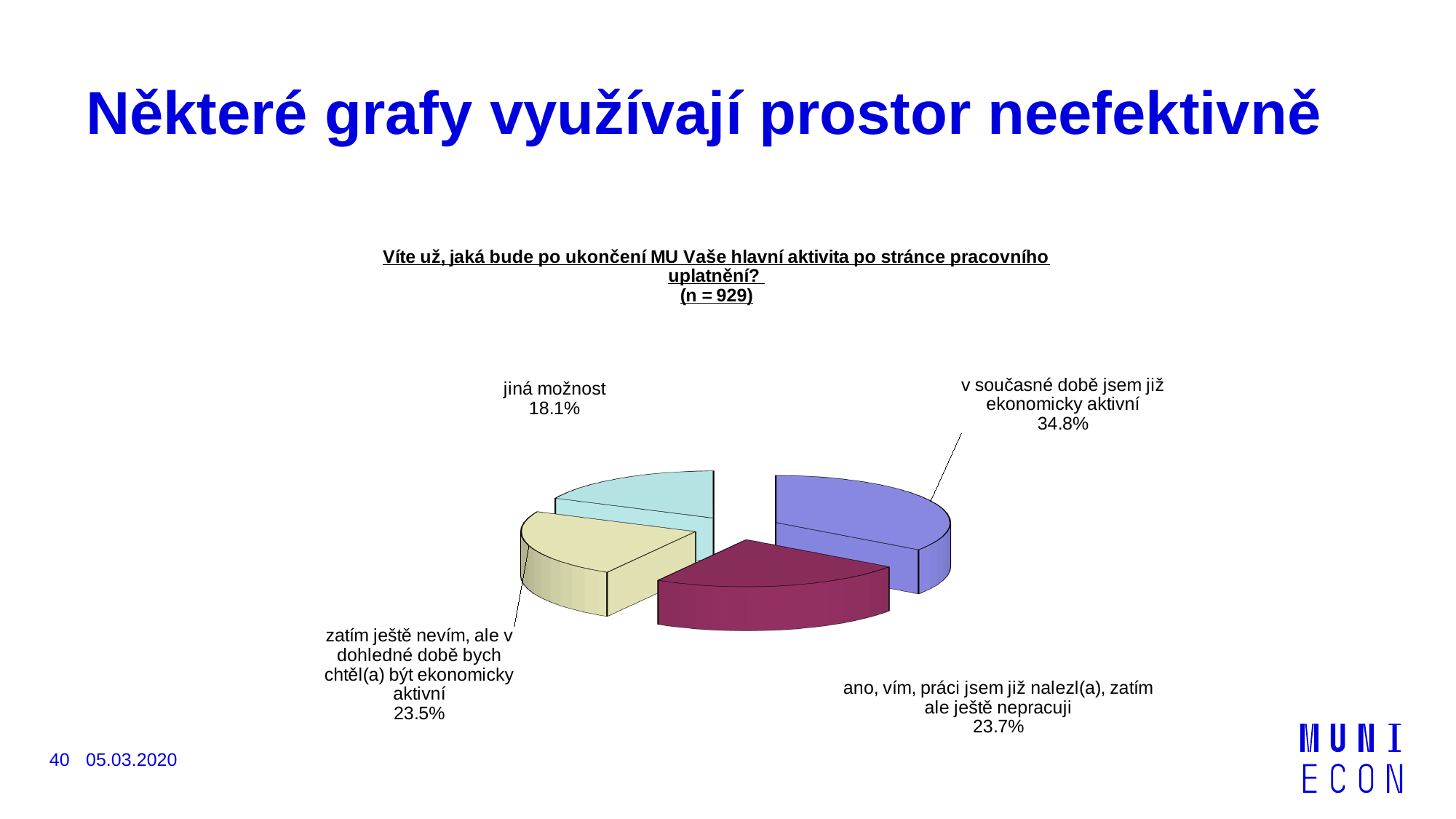
How many slices does the pie chart have? 4 Which is larger: the share for "jiná možnost" or the share for "ano, vím, práci jsem již nalezl(a), zatím ale ještě nepracuji"? ano, vím, práci jsem již nalezl(a), zatím ale ještě nepracuji What share of the pie does "v současné době jsem již ekonomicky aktivní" represent? 34.8% What is the sample size (n) stated in the chart title? 929 What colour is the slice for "v současné době jsem již ekonomicky aktivní"? blue/purple What percentage is shown for "zatím ještě nevím, ale v dohledné době bych chtěl(a) být ekonomicky aktivní"? 23.5% Which category has the smallest share of the pie? jiná možnost What type of chart is shown on the slide? pie chart What share of the pie does "jiná možnost" represent? 18.1% What percentage is shown for "ano, vím, práci jsem již nalezl(a), zatím ale ještě nepracuji"? 23.7% What is the difference in percentage points between "v současné době jsem již ekonomicky aktivní" and "jiná možnost"? 16.7 Which category has the largest share of the pie? v současné době jsem již ekonomicky aktivní